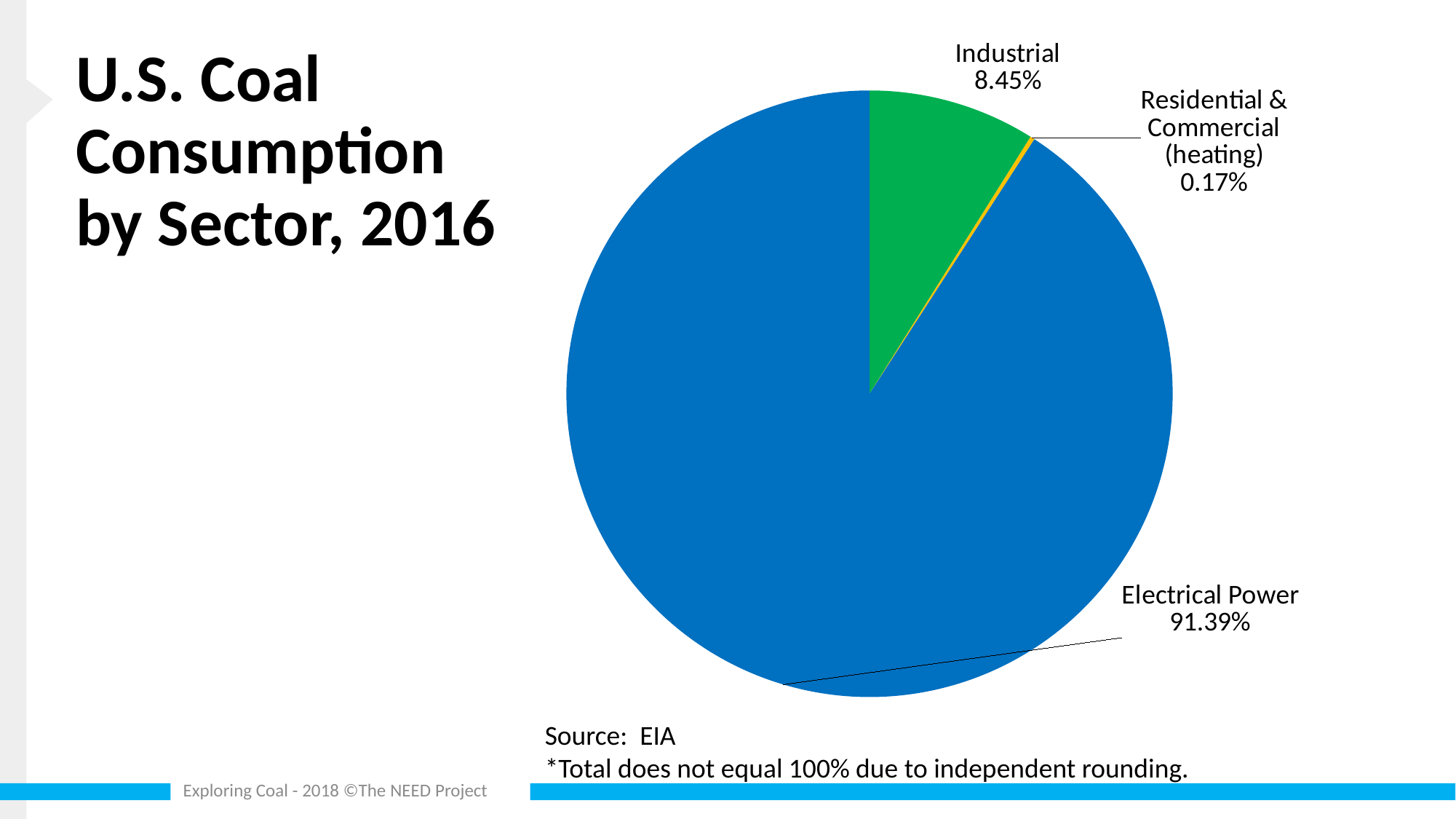
What share of U.S. coal consumption in 2016 went to Residential & Commercial (heating)? 0.17% What kind of chart is shown on the slide? pie chart What is the difference in percentage points between the Industrial share and the Residential & Commercial (heating) share? 8.28 What share of U.S. coal consumption in 2016 went to the Electrical Power sector? 91.39% Which sector has the largest share of U.S. coal consumption in 2016? Electrical Power How many sectors are shown in the pie chart? 3 What is the difference in percentage points between the Electrical Power share and the Industrial share? 82.94 What is the title of the chart on the slide? U.S. Coal Consumption by Sector, 2016 Which sector has the smallest share of U.S. coal consumption in 2016? Residential & Commercial (heating) What colour is the Industrial slice of the pie chart? green What share of U.S. coal consumption in 2016 went to the Industrial sector? 8.45% Which is larger, the Industrial share or the Residential & Commercial (heating) share? Industrial